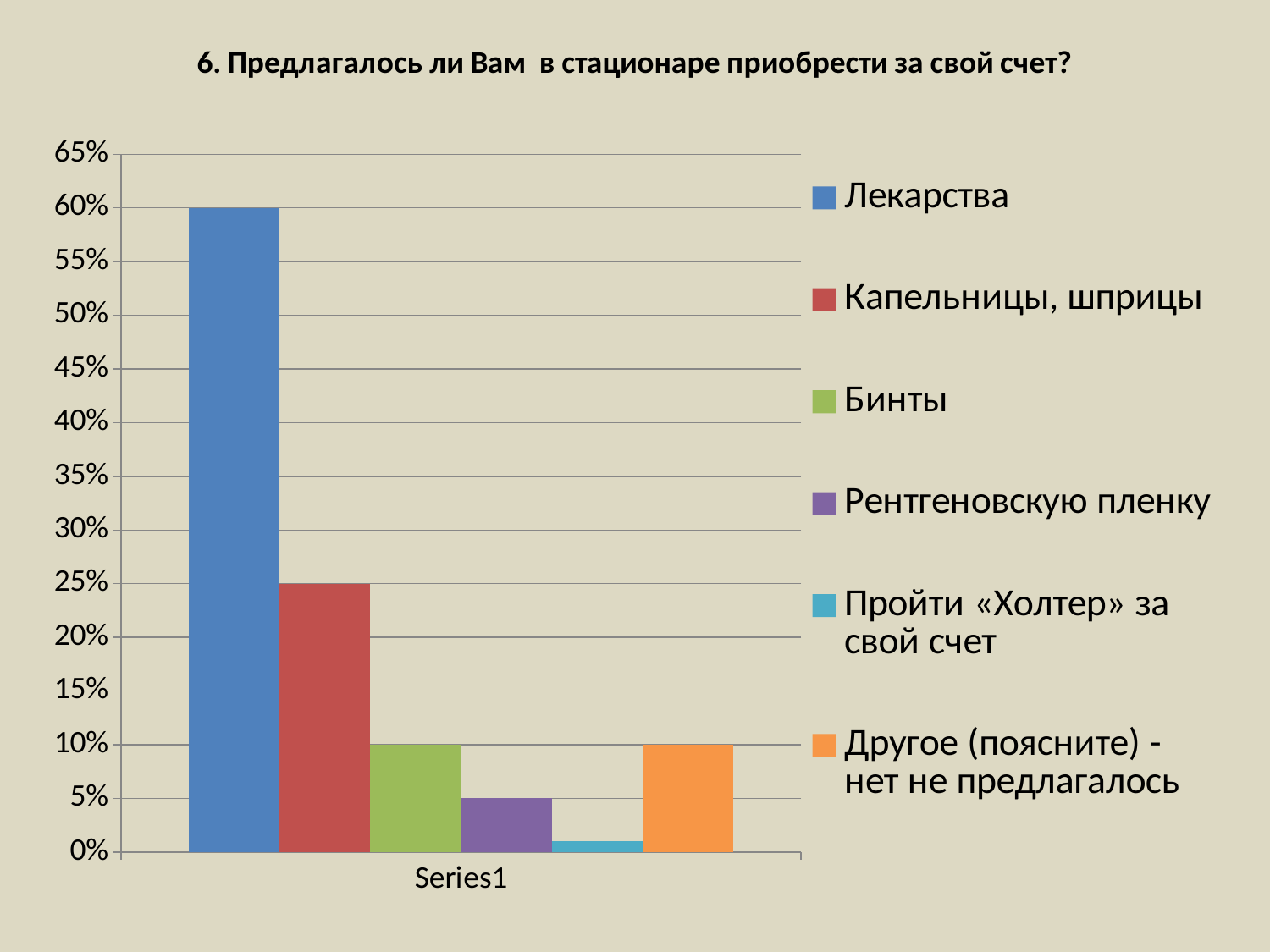
What is the value for Бинты? 10% Is the value for Пройти «Холтер» за свой счет greater or less than 5%? less Which series has the lowest value? Пройти «Холтер» за свой счет What is the value for Капельницы, шприцы? 25% How many series does the legend list? 6 What kind of chart is shown on the slide? bar chart What is the difference between the values for Лекарства and Капельницы, шприцы? 35% What is the value for Лекарства? 60% Which series has the highest value? Лекарства Which is larger, the value for Капельницы, шприцы or the value for Бинты? Капельницы, шприцы What is the value for Рентгеновскую пленку? 5% What is the value for Другое (поясните) - нет не предлагалось? 10%